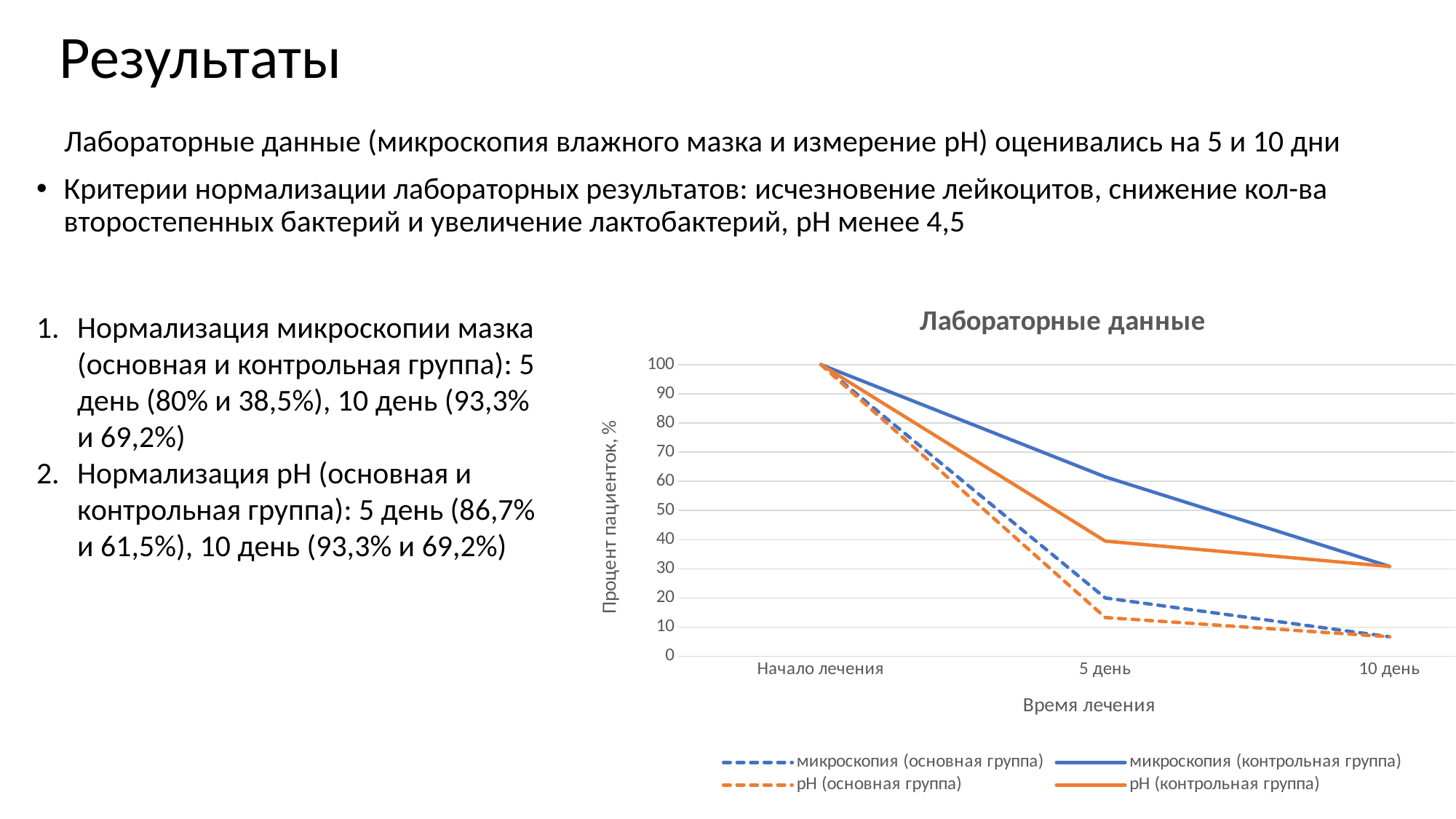
How many series does the chart legend list? 4 How many time points are plotted along the x axis of the chart? 3 At "5 день", which is larger: the value for "pH (контрольная группа)" or the value for "pH (основная группа)"? pH (контрольная группа) What is the value of all series at "Начало лечения"? 100 What is the label of the vertical axis of the chart? Процент пациенток, % Is the value for "pH (контрольная группа)" at "10 день" greater or less than 20? greater Do the values of the series rise or fall from "Начало лечения" to "10 день"? fall Is the value for "микроскопия (основная группа)" at "5 день" greater or less than 30? less Which series has the highest value at "5 день"? микроскопия (контрольная группа) What kind of chart is shown on the slide? line chart Is the value for "микроскопия (контрольная группа)" at "5 день" greater or less than 50? greater What is the title of the chart? Лабораторные данные